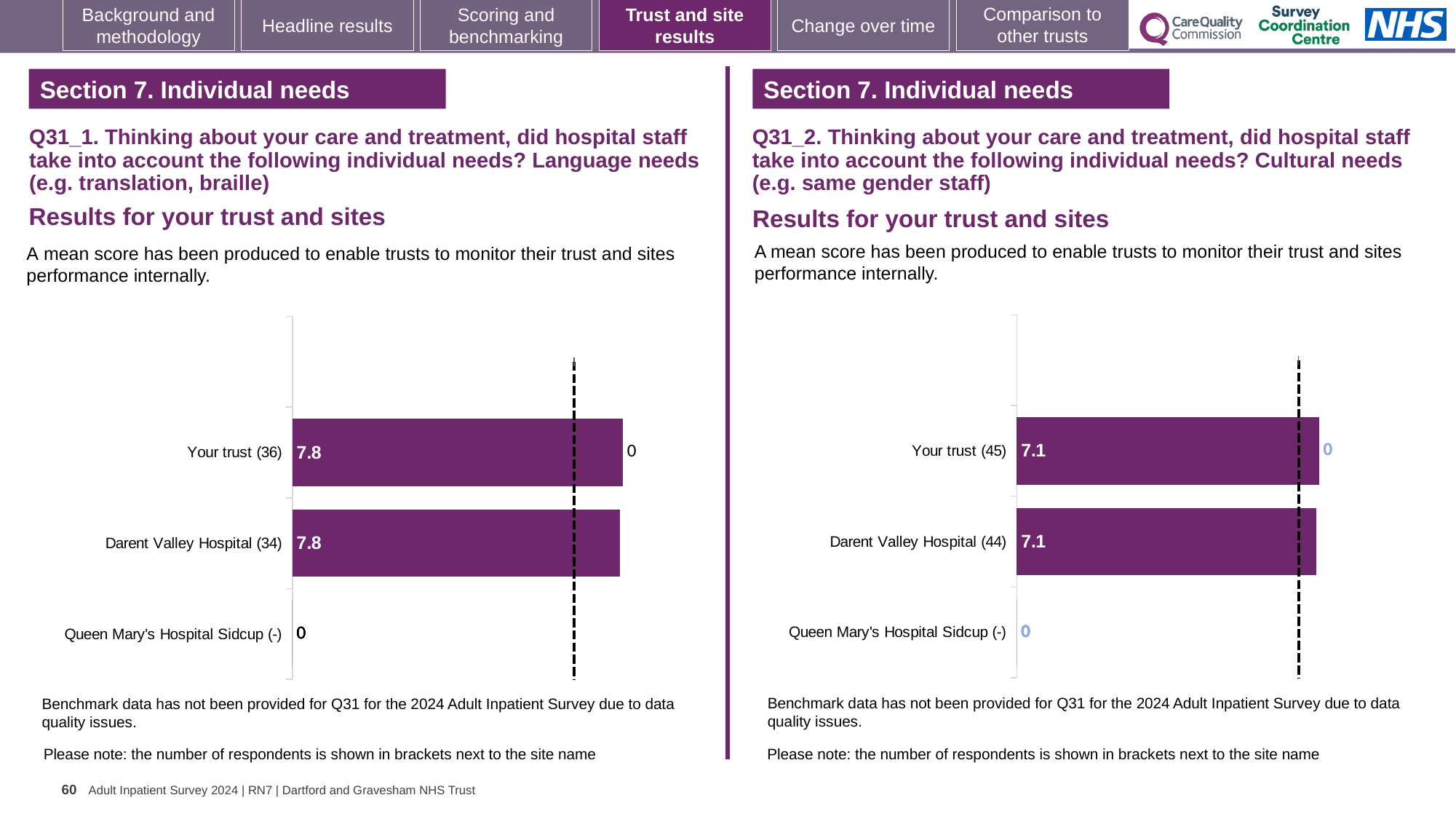
In the left chart (Q31_1, Language needs), how many respondents are shown in brackets for Your trust? 36 In the right chart (Q31_2, Cultural needs), how many respondents are shown in brackets for Darent Valley Hospital? 44 What kind of chart is used in the left chart (Q31_1, Language needs)? Bar chart In the left chart (Q31_1, Language needs), what is the mean score for Your trust? 7.8 In the left chart (Q31_1, Language needs), what is the mean score for Darent Valley Hospital? 7.8 In the left chart (Q31_1, Language needs), what is the difference between the scores for Your trust and Darent Valley Hospital? 0 In the right chart (Q31_2, Cultural needs), what is the mean score for Your trust? 7.1 How many categories are shown on the left chart (Q31_1, Language needs)? 3 How many categories are shown on the right chart (Q31_2, Cultural needs)? 3 Is the score for Your trust in the left chart (Q31_1, Language needs) larger or smaller than the score for Your trust in the right chart (Q31_2, Cultural needs)? Larger In the right chart (Q31_2, Cultural needs), what is the mean score for Darent Valley Hospital? 7.1 In the right chart (Q31_2, Cultural needs), what is the difference between the scores for Your trust and Darent Valley Hospital? 0